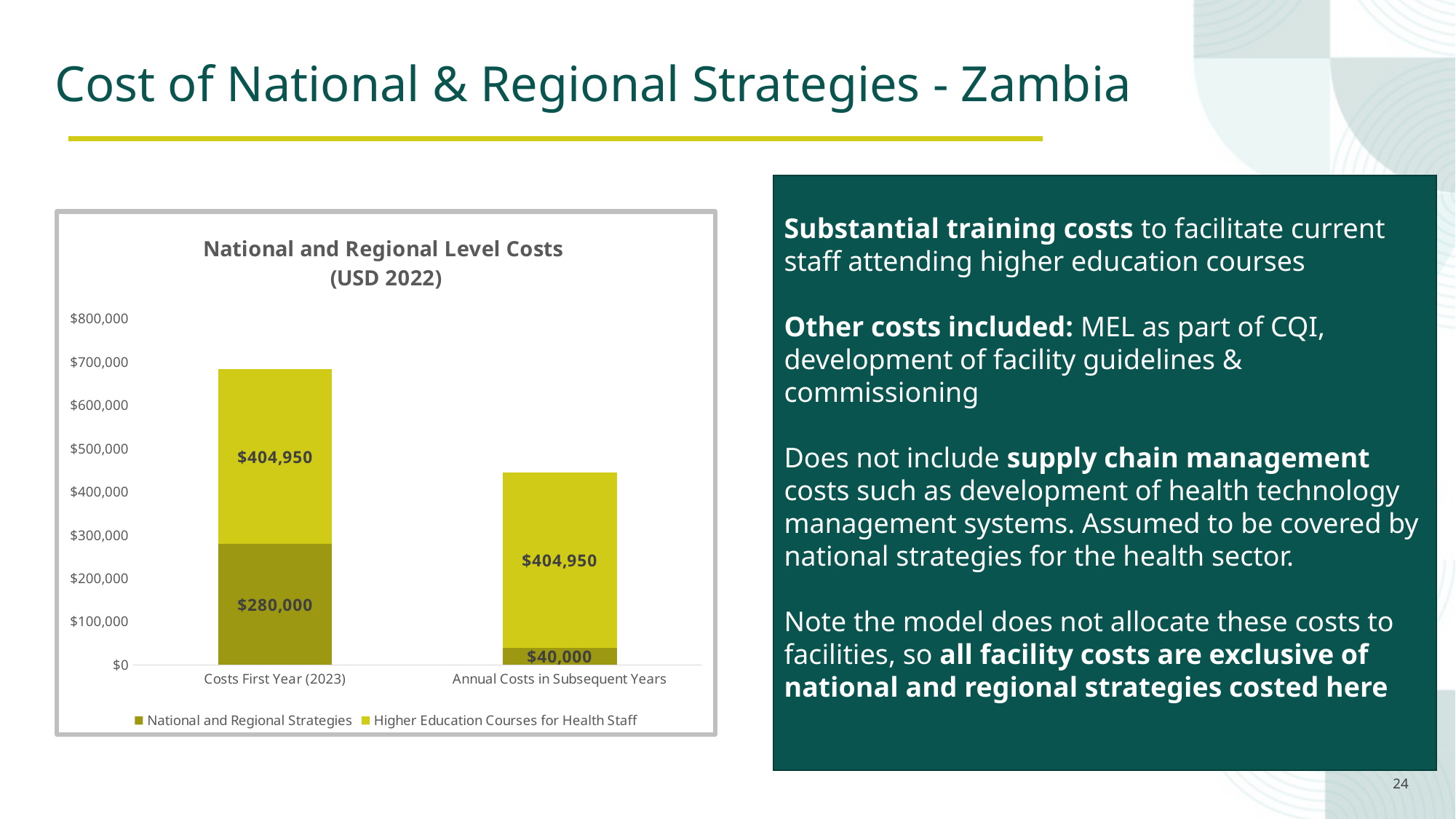
Which category has the higher total cost? Costs First Year (2023) How many series does the legend list? 2 What is the total of the stacked bar for Costs First Year (2023)? $684,950 What kind of chart is shown on the slide? Stacked bar chart Which is larger in Costs First Year (2023): National and Regional Strategies or Higher Education Courses for Health Staff? Higher Education Courses for Health Staff What is the value for National and Regional Strategies in Costs First Year (2023)? $280,000 What is the total of the stacked bar for Annual Costs in Subsequent Years? $444,950 What is the value for Higher Education Courses for Health Staff in Annual Costs in Subsequent Years? $404,950 How many categories are shown on the x axis? 2 Is the total for Costs First Year (2023) greater or less than $600,000? greater What is the value for National and Regional Strategies in Annual Costs in Subsequent Years? $40,000 What is the difference between the National and Regional Strategies values for Costs First Year (2023) and Annual Costs in Subsequent Years? $240,000